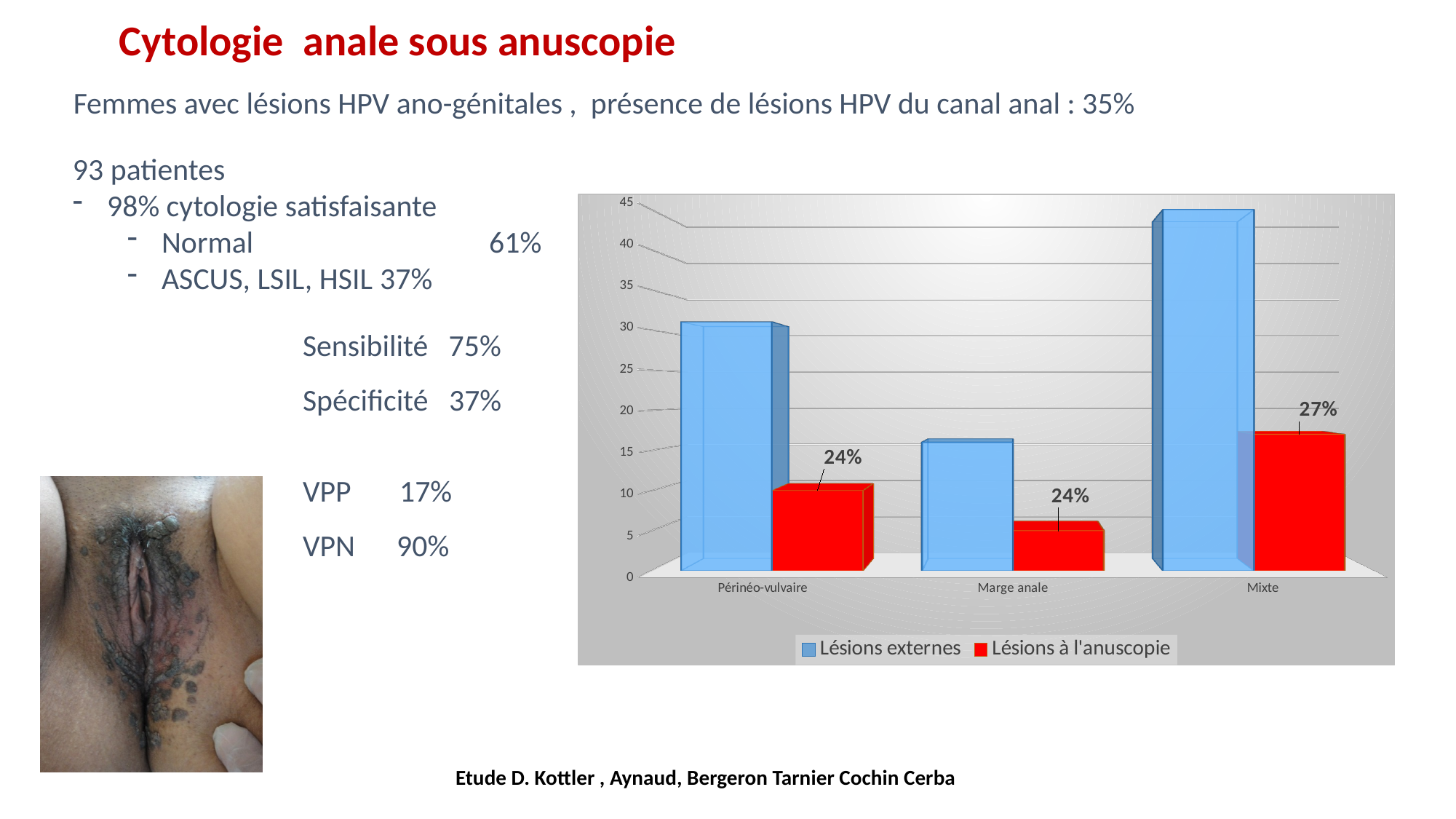
How many series does the chart legend list? 2 Which is larger, the Lésions externes bar for Périnéo-vulvaire or for Marge anale? Périnéo-vulvaire What is the data label on the Lésions à l'anuscopie bar for Marge anale? 24% Which category has the highest labelled value for Lésions à l'anuscopie? Mixte How many categories are shown on the x axis of the chart? 3 Is the Lésions externes value for Marge anale greater or less than 20? less Which category has the lowest Lésions externes bar? Marge anale Is the Lésions externes value for Mixte greater or less than 40? greater What kind of chart is shown on the slide? bar chart What is the data label on the Lésions à l'anuscopie bar for Périnéo-vulvaire? 24% What is the data label on the Lésions à l'anuscopie bar for Mixte? 27% Which category has the highest Lésions externes bar? Mixte